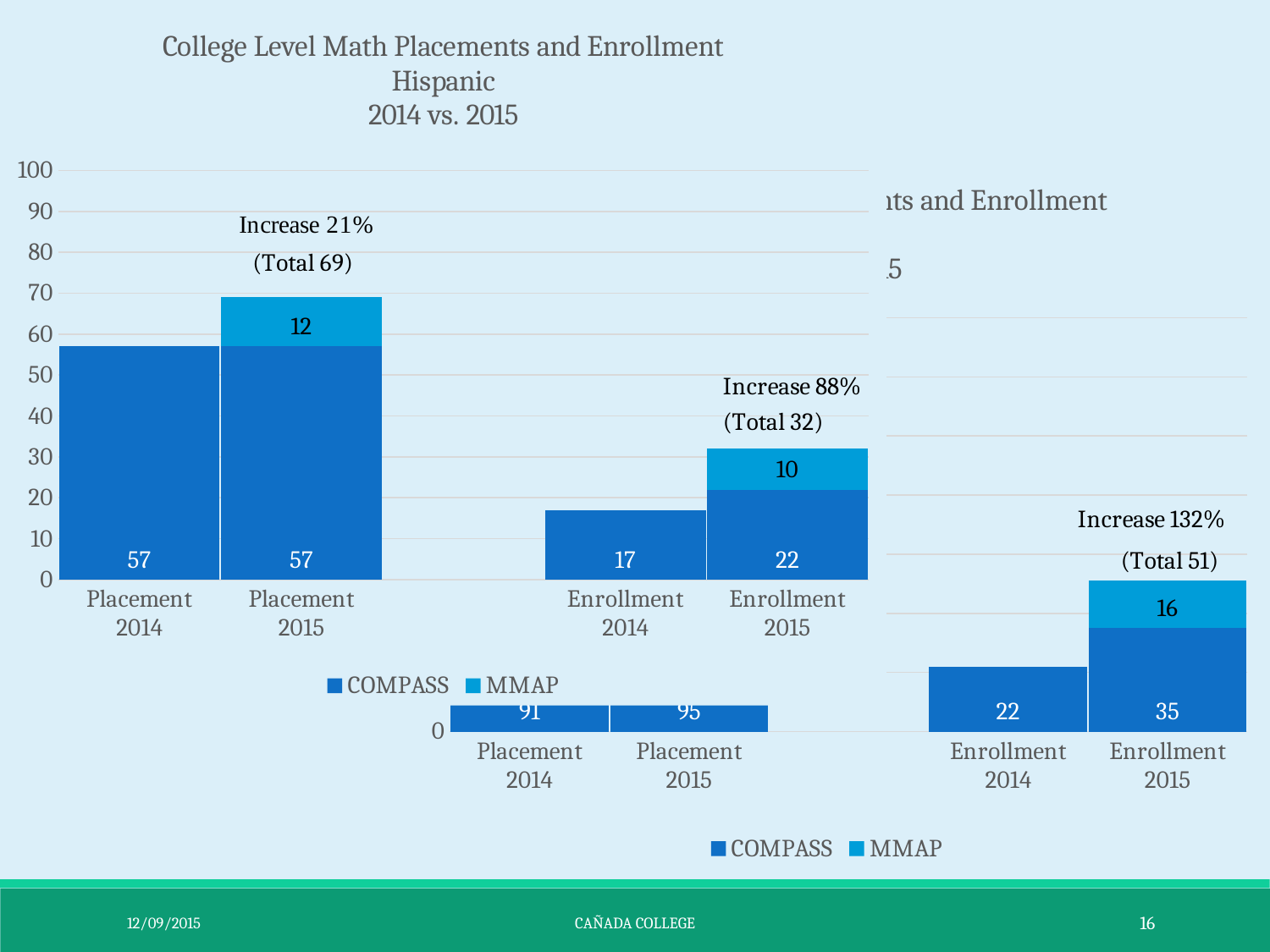
In the 'College Level Math Placements and Enrollment Hispanic 2014 vs. 2015' chart, what is the COMPASS value for Placement 2014? 57 In the Hispanic 2014 vs. 2015 chart, which category has the lowest total bar? Enrollment 2014 In the Hispanic 2014 vs. 2015 chart, what is the COMPASS value for Enrollment 2014? 17 In the Hispanic 2014 vs. 2015 chart, what is the total of the stacked bar for Enrollment 2015? 32 What type of chart is the Hispanic 2014 vs. 2015 chart? Stacked bar chart In the Hispanic 2014 vs. 2015 chart, what is the MMAP value for Placement 2015? 12 In the Hispanic 2014 vs. 2015 chart, what is the total of the stacked bar for Placement 2015? 69 In the Hispanic 2014 vs. 2015 chart, what is the difference between the COMPASS values for Enrollment 2015 and Enrollment 2014? 5 In the partially hidden chart on the right of the slide, what is the MMAP value for Enrollment 2015? 16 In the partially hidden chart on the right of the slide, what is the COMPASS value for Enrollment 2014? 22 In the Hispanic 2014 vs. 2015 chart, what percentage increase is annotated above the Enrollment 2015 bar? Increase 88% In the Hispanic 2014 vs. 2015 chart, how many series does the legend list? 2